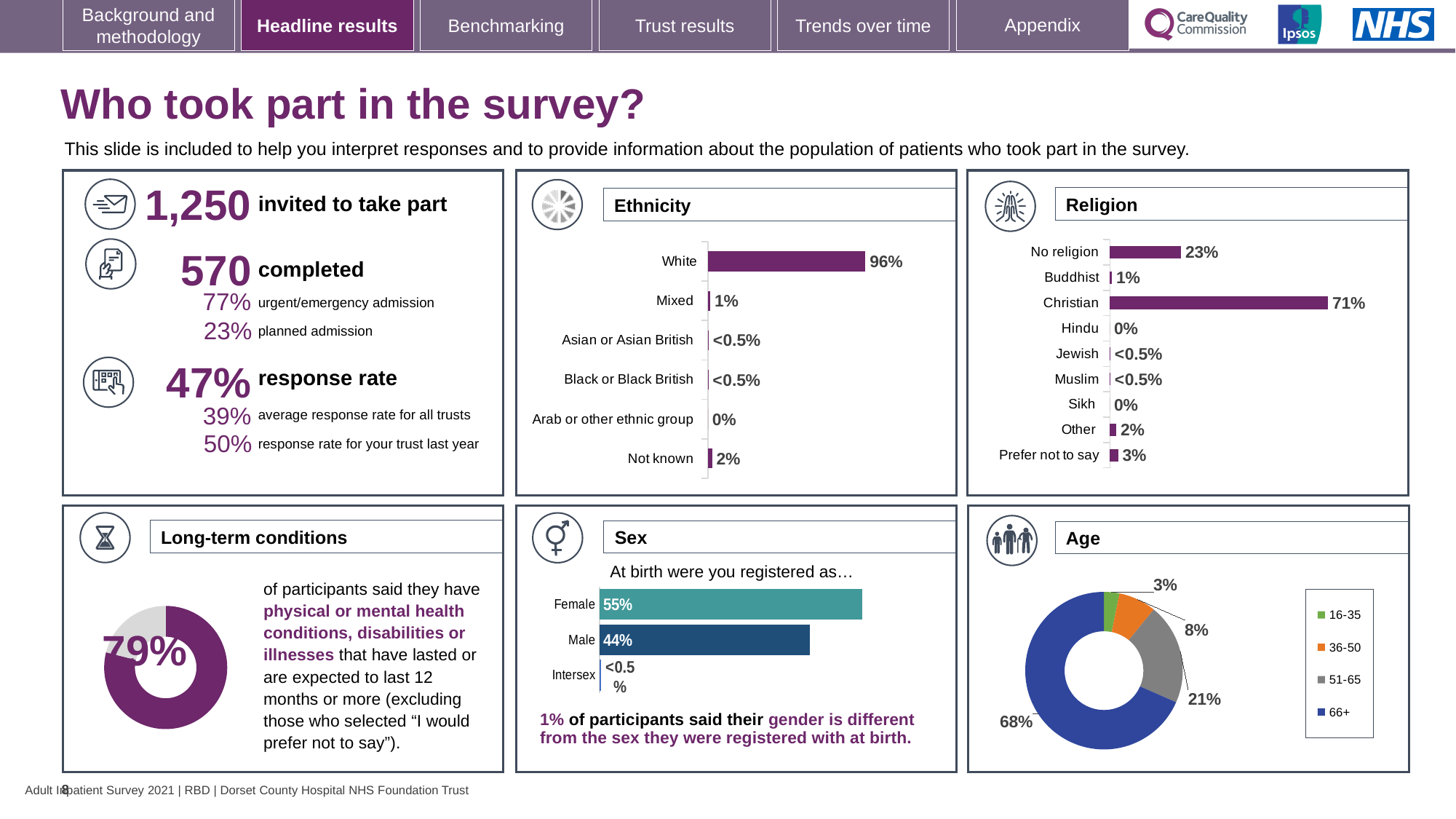
In the Ethnicity chart, what percentage of participants were White? 96% In the Sex chart, which is larger, Female or Male? Female How many categories are shown in the Ethnicity chart? 6 In the Age chart, what share of participants were aged 66+? 68% In the Religion chart, what percentage of participants were Christian? 71% In the Religion chart, what is the difference between the Christian and No religion values? 48% How many entries does the legend of the Age chart list? 4 In the Age chart, which age group has the smallest share? 16-35 How many categories are shown in the Religion chart? 9 What kind of chart is the Religion chart? Bar chart In the Sex chart, what percentage of participants were registered as Male at birth? 44% In the Ethnicity chart, which category has the highest value? White